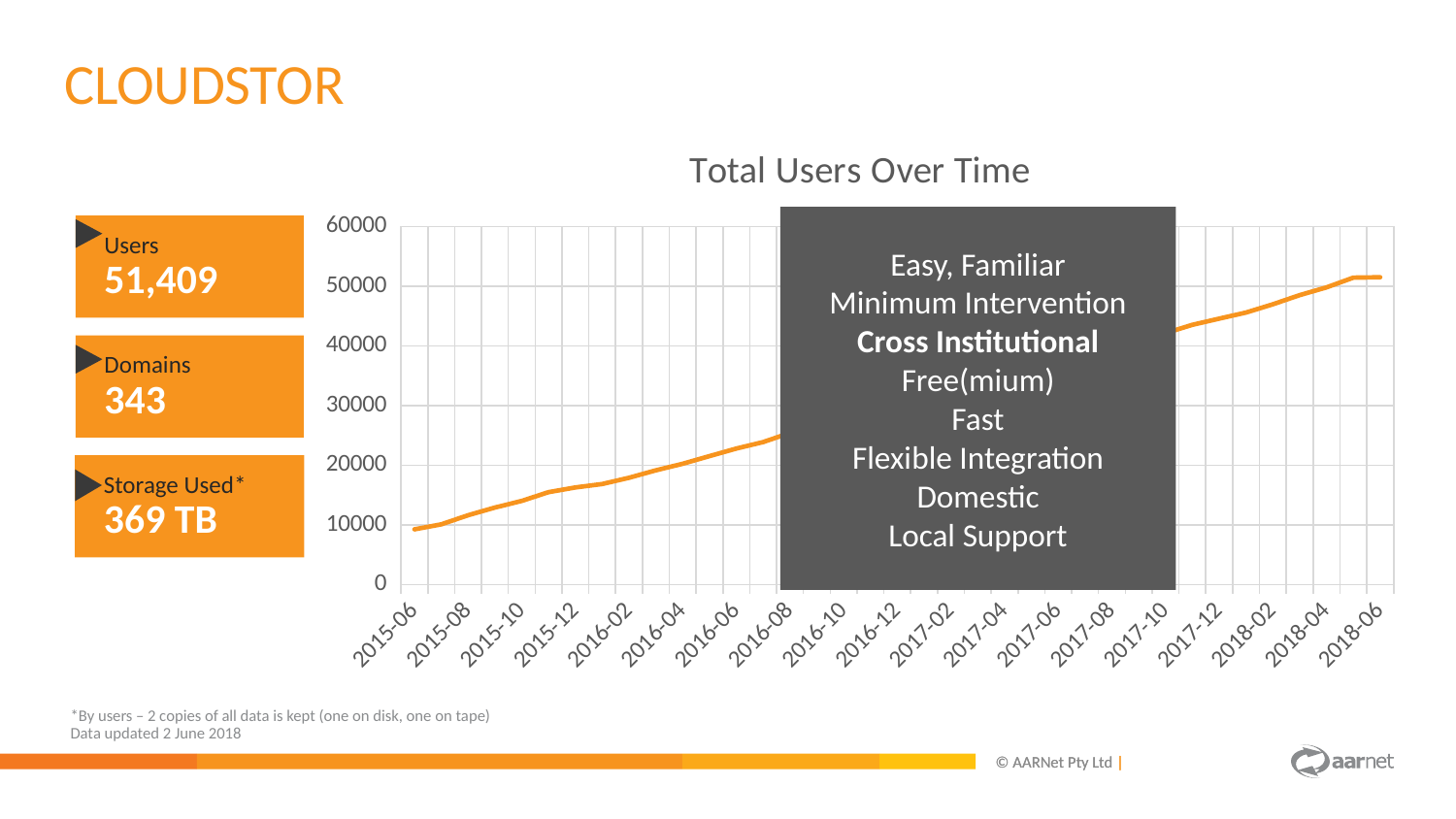
How many date labels are shown on the x axis of the chart? 19 Is the value for 2017-10 greater or less than 30000? greater Is the value for 2018-06 greater or less than 40000? greater Is the value for 2015-06 greater or less than 20000? less Do the total users rise or fall over time along the x axis of the chart? rise Which is larger, the value for 2018-06 or the value for 2015-06? 2018-06 What is the title of the chart on the slide? Total Users Over Time Which date on the x axis has the lowest total users? 2015-06 What type of chart is shown under the title "Total Users Over Time"? line chart What is the highest value shown on the y axis of the chart? 60000 Which date on the x axis has the highest total users? 2018-06